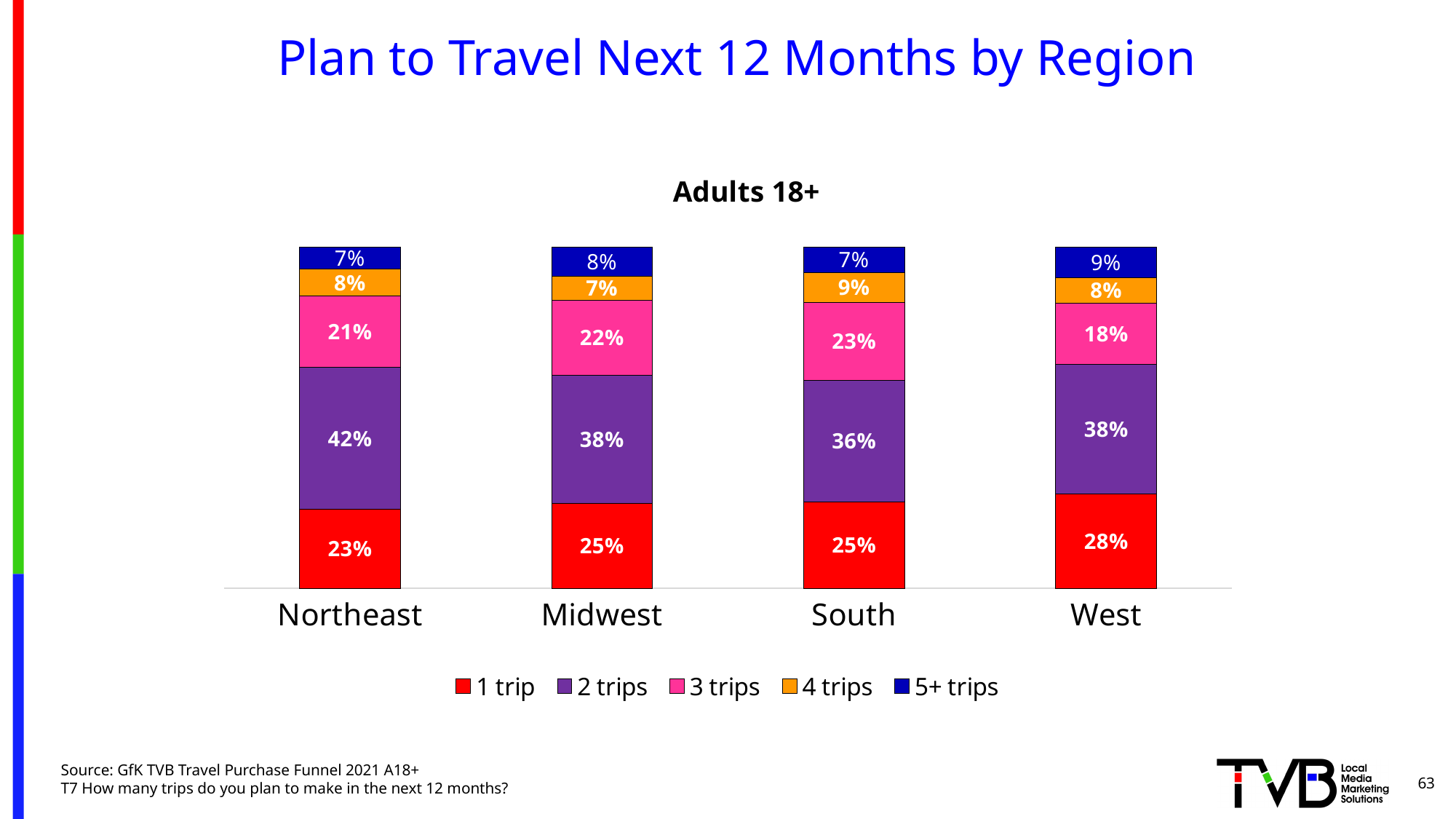
What percentage of adults in the West plan to make 1 trip? 28% How many percentage points higher is the 1 trip value for the West than for the Northeast? 5 percentage points What is the value for 3 trips in the South? 23% How many series does the legend list? 5 What percentage of adults in the Northeast plan to make 2 trips? 42% Which region has the highest percentage planning 2 trips? Northeast What kind of chart is shown on the slide? Stacked bar chart What is the total of the stacked bar for the Midwest? 100% What is the value for 5+ trips in the Midwest? 8% How many regions are shown on the x axis? 4 Which region has the lowest percentage planning 3 trips? West Which is larger, the 4 trips value for the South or for the Midwest? South